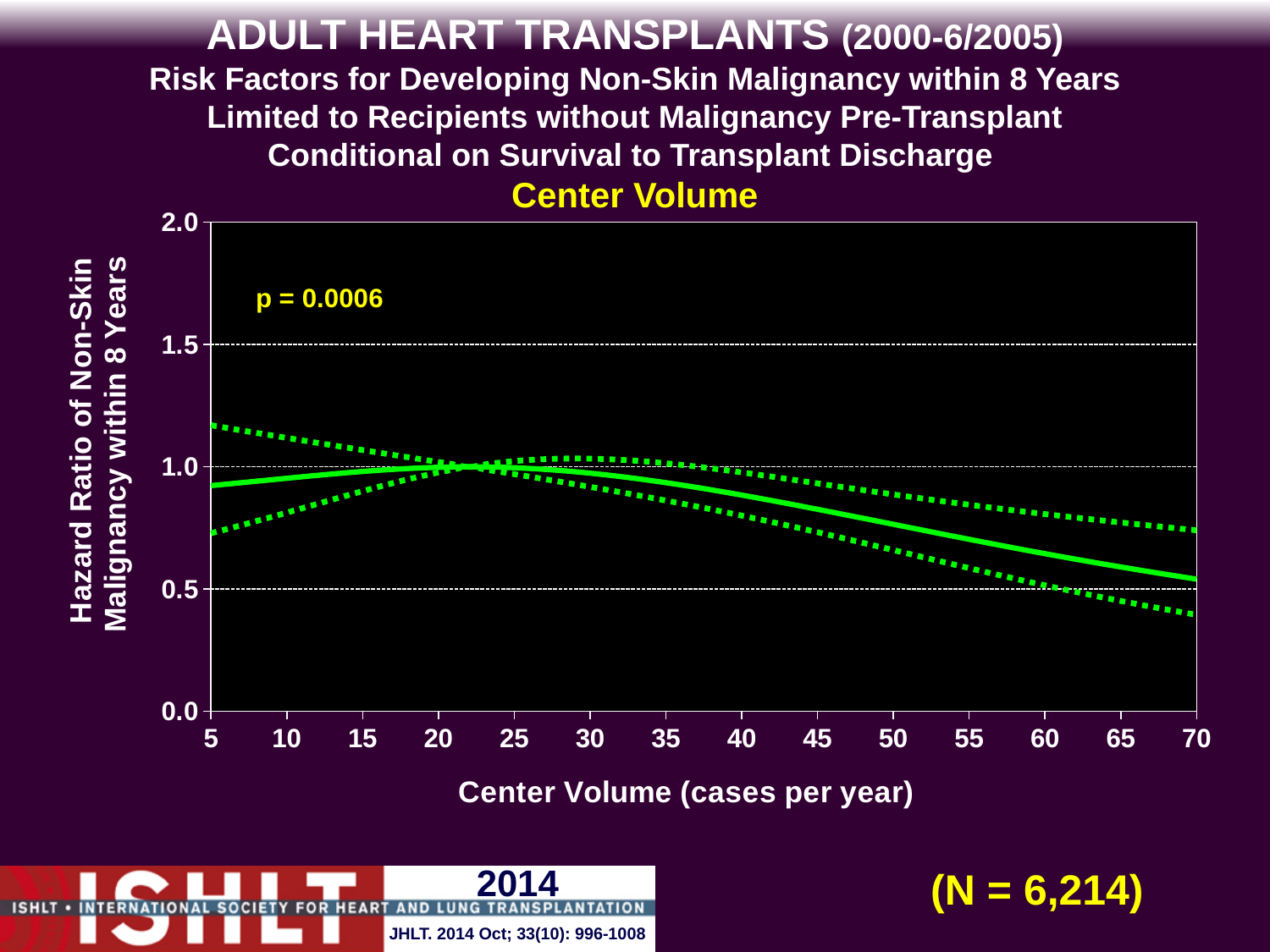
Does the solid hazard ratio line rise or fall as center volume increases from 30 to 70 cases per year? fall How many tick labels are shown on the x axis? 14 Is the value of the solid hazard ratio line at a center volume of 70 cases per year greater or less than 1.0? less Is the value of the upper dotted line at a center volume of 5 cases per year greater or less than 1.0? greater How many lines are plotted on the chart? 3 What is the label of the x axis? Center Volume (cases per year) Is the value of the lower dotted line at a center volume of 5 cases per year greater or less than 1.0? less What p-value is printed on the chart? p = 0.0006 What is the highest value labelled on the y axis? 2.0 What kind of chart is shown on the slide? line chart